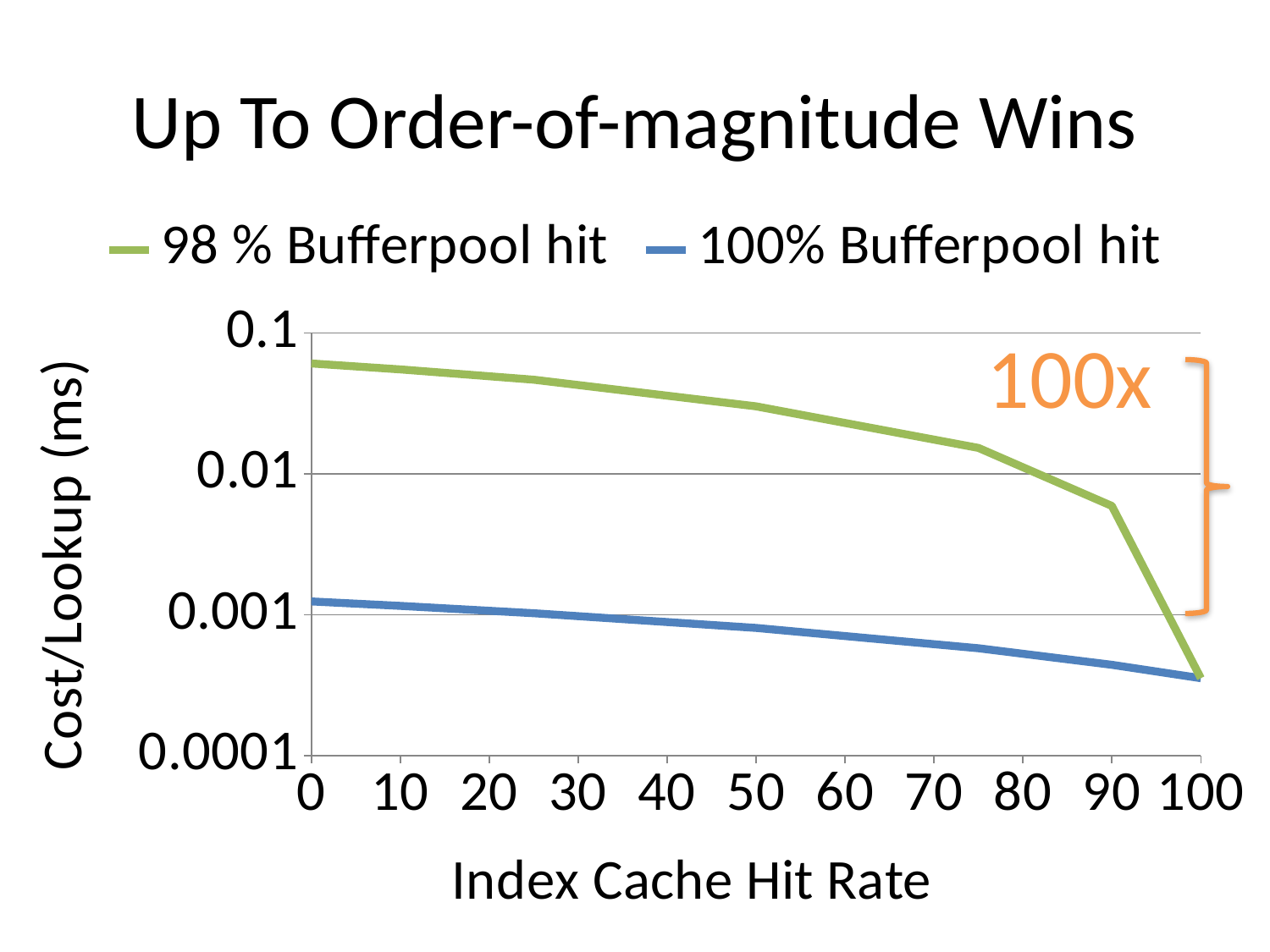
Is the value for the 98 % Bufferpool hit series at an Index Cache Hit Rate of 0 greater or less than 0.01? greater At an Index Cache Hit Rate of 50, which series has the higher cost per lookup, 98 % Bufferpool hit or 100% Bufferpool hit? 98 % Bufferpool hit What are the two series named in the legend? 98 % Bufferpool hit and 100% Bufferpool hit Is the value for the 98 % Bufferpool hit series at an Index Cache Hit Rate of 50 greater or less than 0.01? greater Does the cost per lookup for the 98 % Bufferpool hit series rise or fall as the Index Cache Hit Rate increases? fall Is the value for the 100% Bufferpool hit series at an Index Cache Hit Rate of 100 greater or less than 0.001? less What kind of chart is shown on the slide? line chart What is the label of the x axis? Index Cache Hit Rate Which series has the higher cost per lookup at an Index Cache Hit Rate of 0? 98 % Bufferpool hit Does the cost per lookup for the 100% Bufferpool hit series rise or fall as the Index Cache Hit Rate increases? fall How many series does the legend list? 2